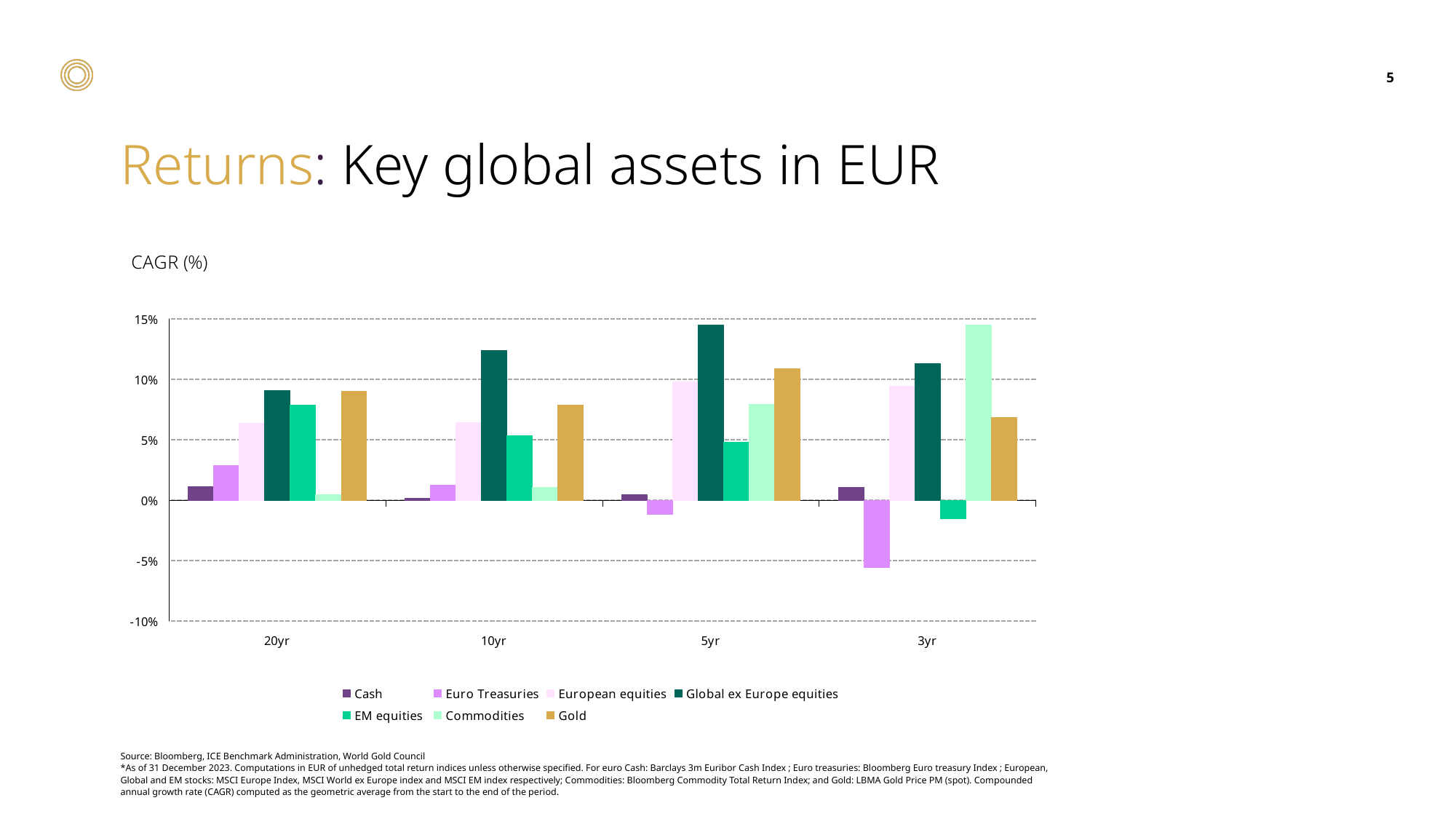
In the 5yr period, which is larger: European equities or EM equities? European equities What kind of chart is shown on the slide? bar chart How many series does the legend list? 7 Is the value for Gold in the 5yr period greater or less than 10%? greater Which asset has the highest CAGR in the 5yr period? Global ex Europe equities Is the value for Global ex Europe equities in the 10yr period greater or less than 10%? greater Which asset has the highest CAGR in the 10yr period? Global ex Europe equities Which asset has the highest CAGR in the 3yr period? Commodities How many time-period categories are shown on the x axis? 4 What label is shown above the chart describing the measure plotted? CAGR (%) Which asset has the lowest CAGR in the 3yr period? Euro Treasuries Is the value for Euro Treasuries in the 3yr period greater or less than -5%? less